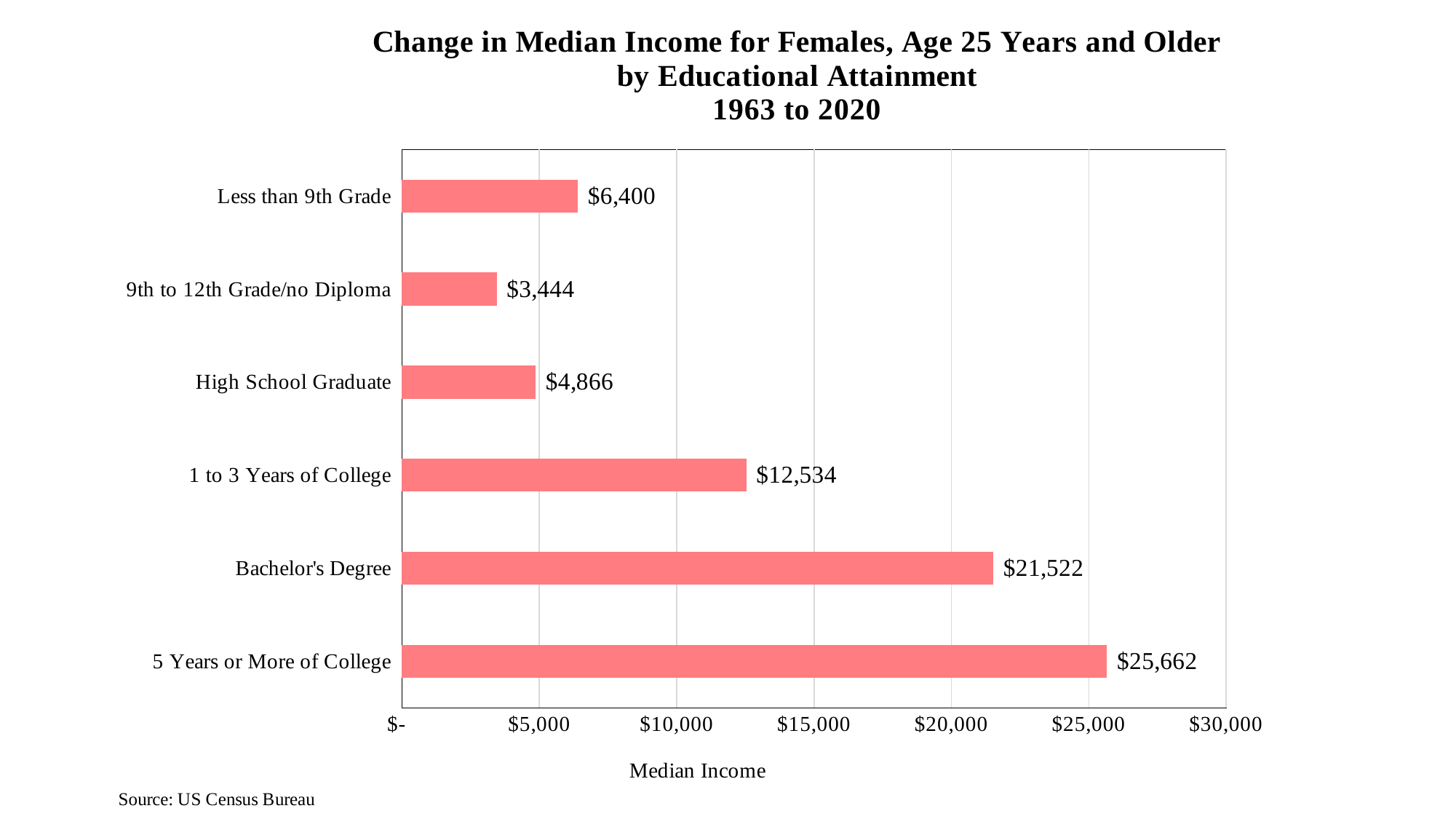
What is the difference between the values for 5 Years or More of College and Bachelor's Degree? $4,140 What is the change in median income for females with Less than 9th Grade education? $6,400 Which educational attainment category has the lowest change in median income? 9th to 12th Grade/no Diploma What is the value shown for 1 to 3 Years of College? $12,534 What is the difference between the values for High School Graduate and 9th to 12th Grade/no Diploma? $1,422 Is the value for 1 to 3 Years of College greater or less than $10,000? greater What kind of chart is shown on the slide? Bar chart Which educational attainment category has the highest change in median income? 5 Years or More of College What is the label of the horizontal axis? Median Income Which is larger, the value for Less than 9th Grade or the value for High School Graduate? Less than 9th Grade How many educational attainment categories are shown in the chart? 6 What is the change in median income for females with a Bachelor's Degree? $21,522